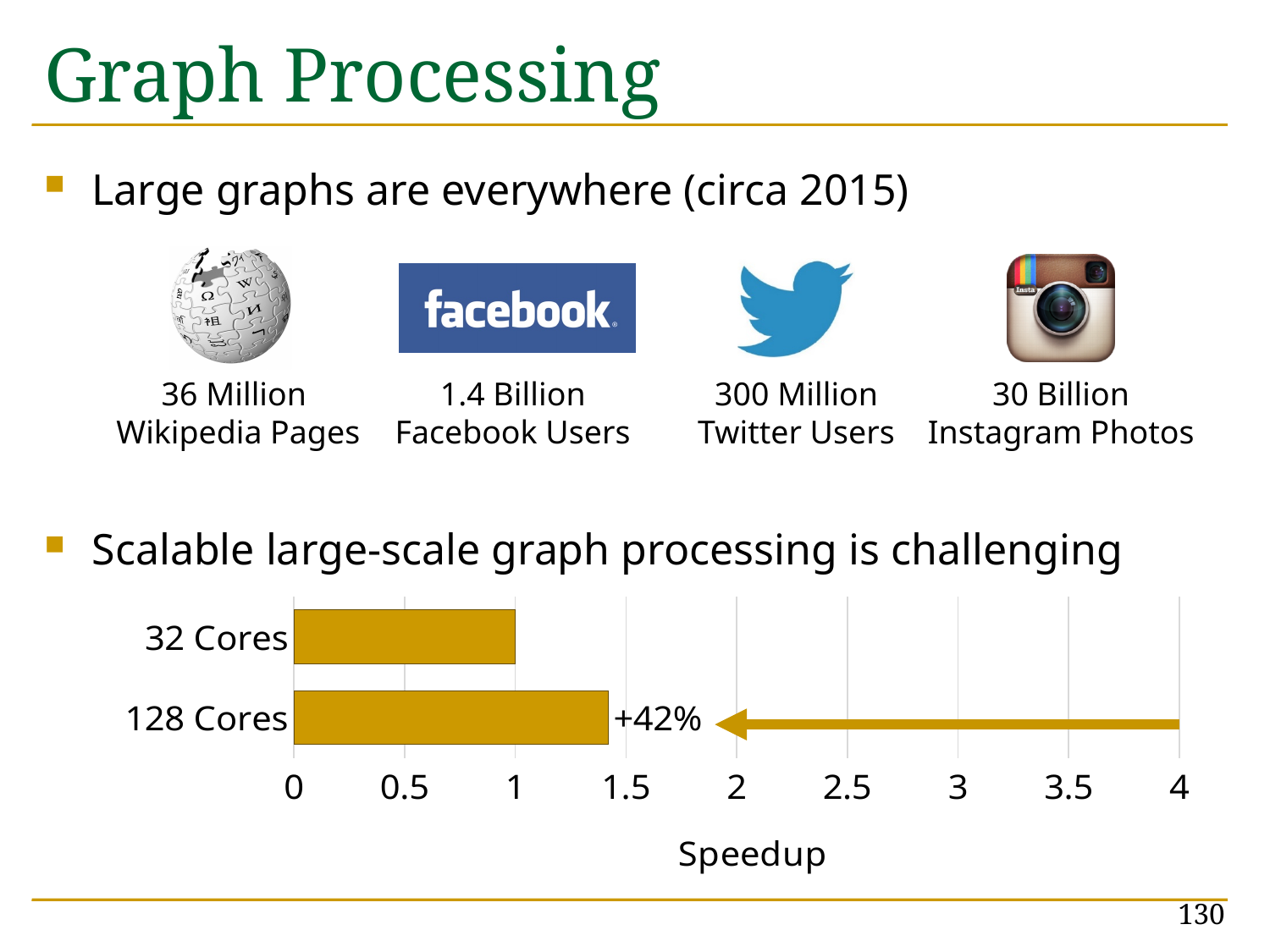
What percentage improvement is annotated next to the 128 Cores bar? +42% Which category has the lowest speedup in the bar chart? 32 Cores Is the speedup for 128 Cores greater or less than 1.5? less What is the maximum value shown on the Speedup axis? 4 Which has a larger speedup, 32 Cores or 128 Cores? 128 Cores Which category has the highest speedup in the bar chart? 128 Cores What kind of chart is shown on the slide? bar chart How many categories does the bar chart show? 2 What is the speedup value for 32 Cores? 1 What is the title of the horizontal axis of the bar chart? Speedup Is the speedup for 128 Cores greater or less than 1? greater